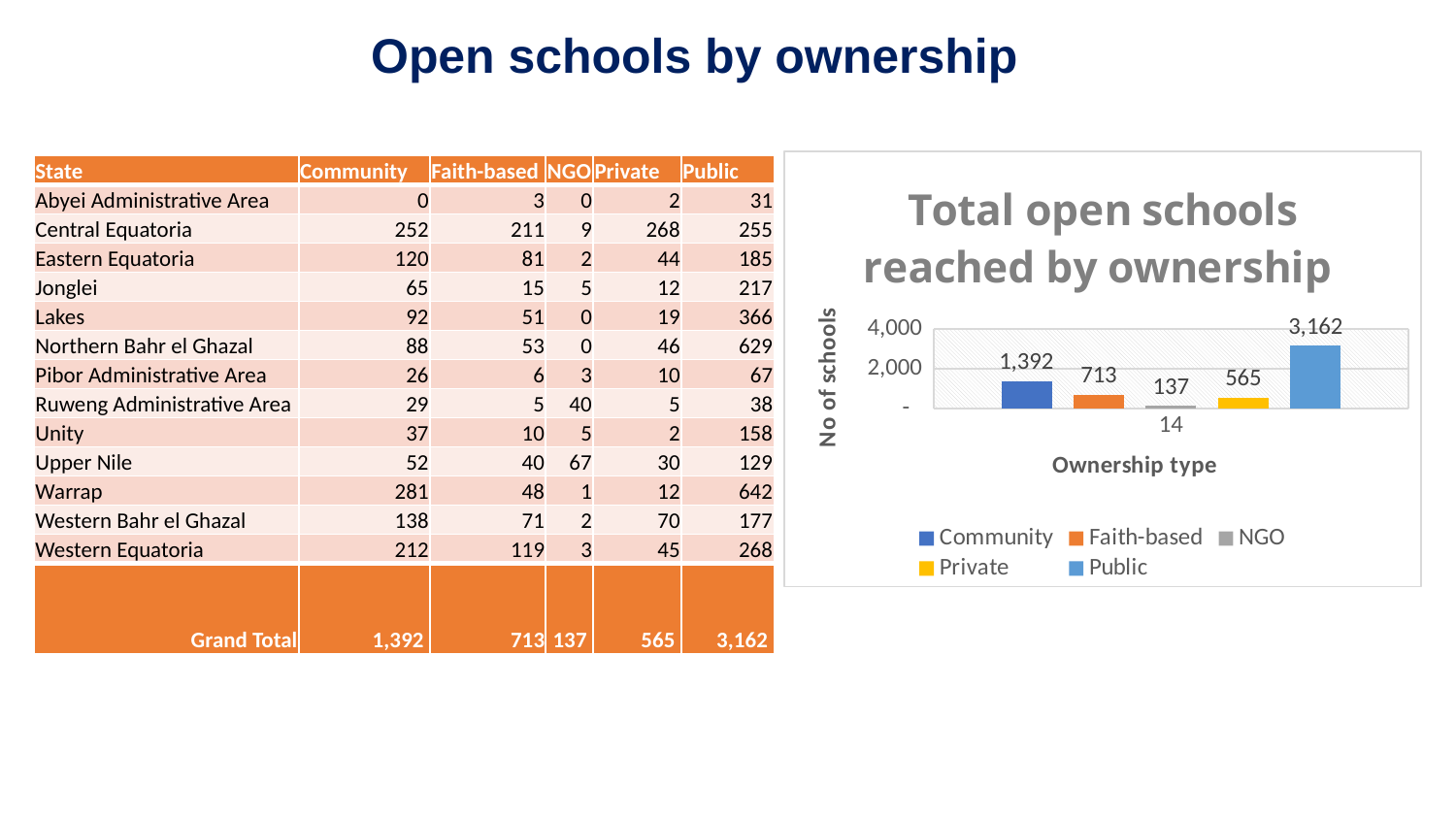
Which is larger in the chart, Faith-based or Private? Faith-based Is the value for Public greater or less than 2,000? greater What is the difference between the Public and Community values in the chart? 1,770 What is the value for NGO in the chart? 137 What is the value for Community in the chart? 1,392 What is the value for Public in the chart? 3,162 What kind of chart is shown on the slide? bar chart Which ownership type has the highest number of open schools in the chart? Public What is the value for Private in the chart? 565 Which ownership type has the lowest number of open schools in the chart? NGO How many series does the chart legend list? 5 What is the title of the chart? Total open schools reached by ownership